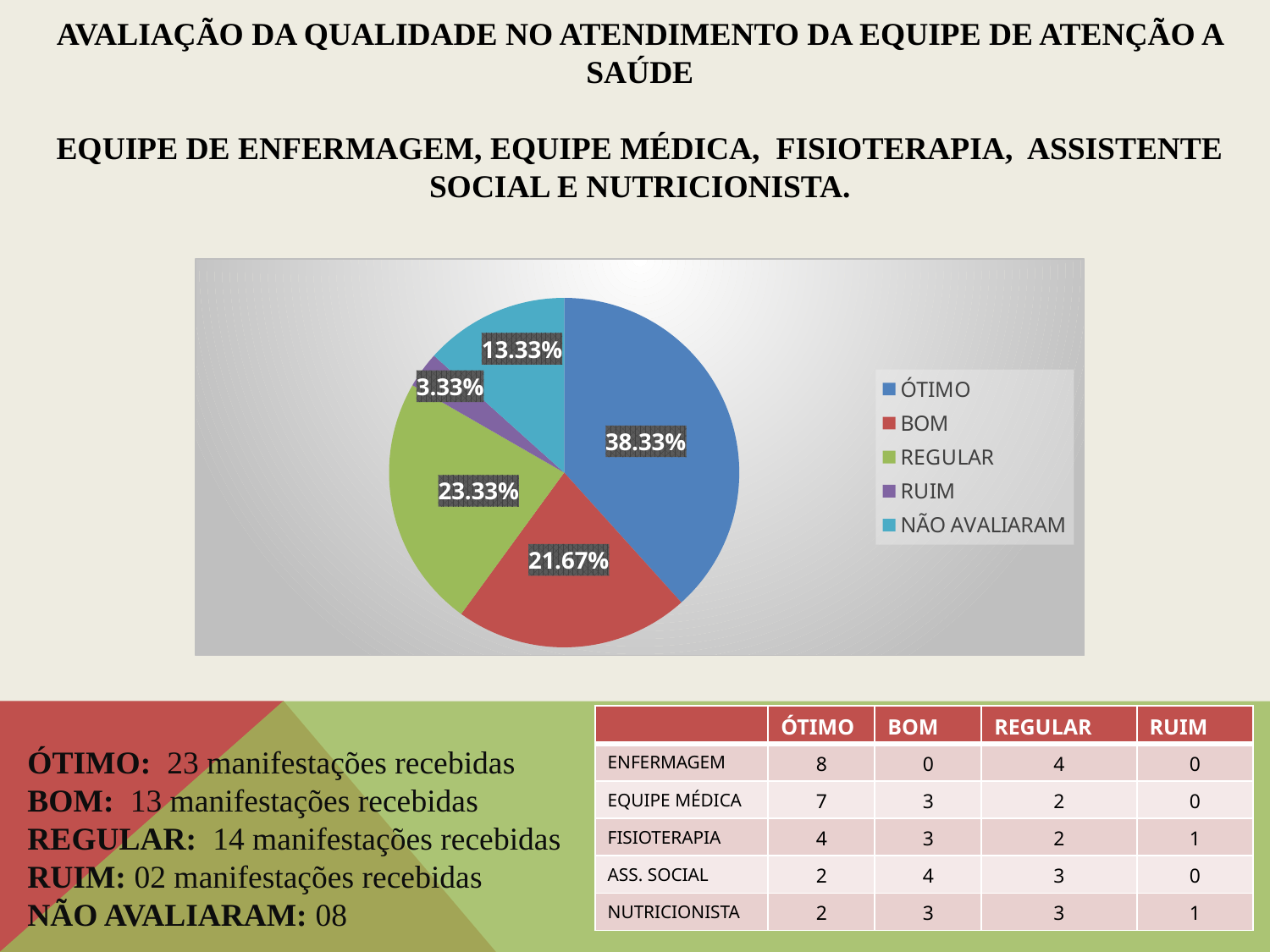
What kind of chart is shown on the slide? pie chart What percentage of the pie chart is labelled for REGULAR? 23.33% What percentage of the pie chart is labelled for NÃO AVALIARAM? 13.33% What percentage of the pie chart is labelled for RUIM? 3.33% Which category has the largest slice of the pie chart? ÓTIMO Which category has the smallest slice of the pie chart? RUIM What is the difference in percentage points between the ÓTIMO slice and the BOM slice? 16.66 Which slice is larger in the pie chart, REGULAR or NÃO AVALIARAM? REGULAR What colour is the ÓTIMO slice in the pie chart? blue How many slices does the pie chart have? 5 What percentage of the pie chart is labelled for BOM? 21.67% What percentage of the pie chart is labelled for ÓTIMO? 38.33%